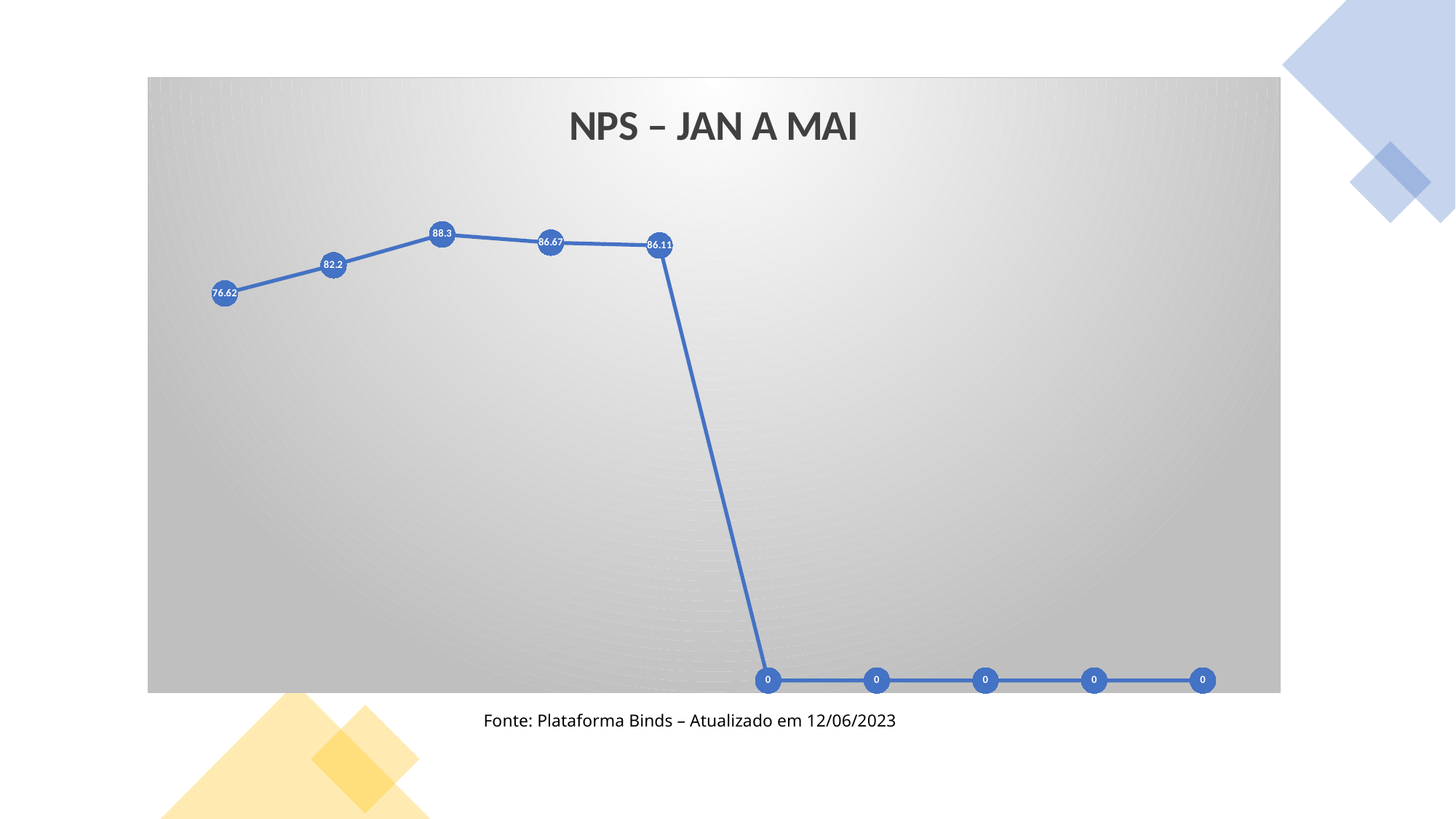
What is the difference between the third data point (88.3) and the first data point (76.62)? 11.68 Do the values rise or fall across the first three data points? rise How many data points are plotted on the line? 10 What is the value of the fifth data point from the left? 86.11 What kind of chart is shown on the slide? line chart What is the value of the first (leftmost) data point? 76.62 What is the value of the fourth data point from the left? 86.67 What is the highest value plotted on the chart? 88.3 Which is larger, the second data point or the fourth data point? the fourth data point (86.67) What is the value of the second data point from the left? 82.2 What is the value of the last five data points on the right? 0 What is the title of the chart? NPS – JAN A MAI